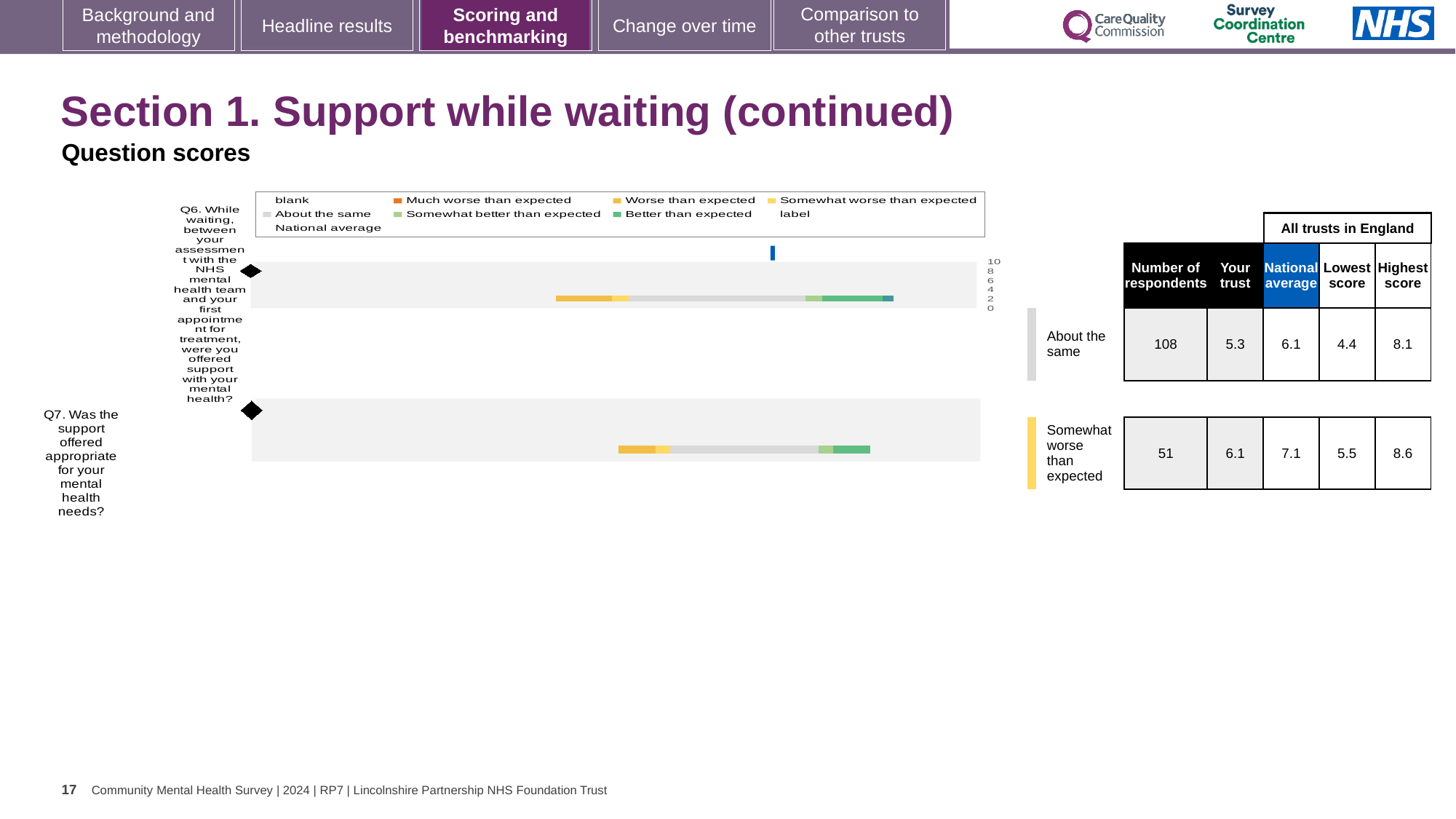
Which colour in the legend represents 'About the same'? grey Which benchmark category is Q7 assigned to? Somewhat worse than expected What is the number of respondents for Q6? 108 What is the difference between the national average and the 'Your trust' score for Q6? 0.8 For Q6, which is larger: the 'Your trust' score or the national average? National average What kind of chart is shown on the slide? bar chart What is the national average score for Q7? 7.1 What is the lowest score among all trusts in England for Q6? 4.4 What is the highest score among all trusts in England for Q7? 8.6 What is the difference between the highest and lowest scores for Q7? 3.1 How many questions (categories) are plotted in the chart? 2 What is the 'Your trust' score for Q6? 5.3